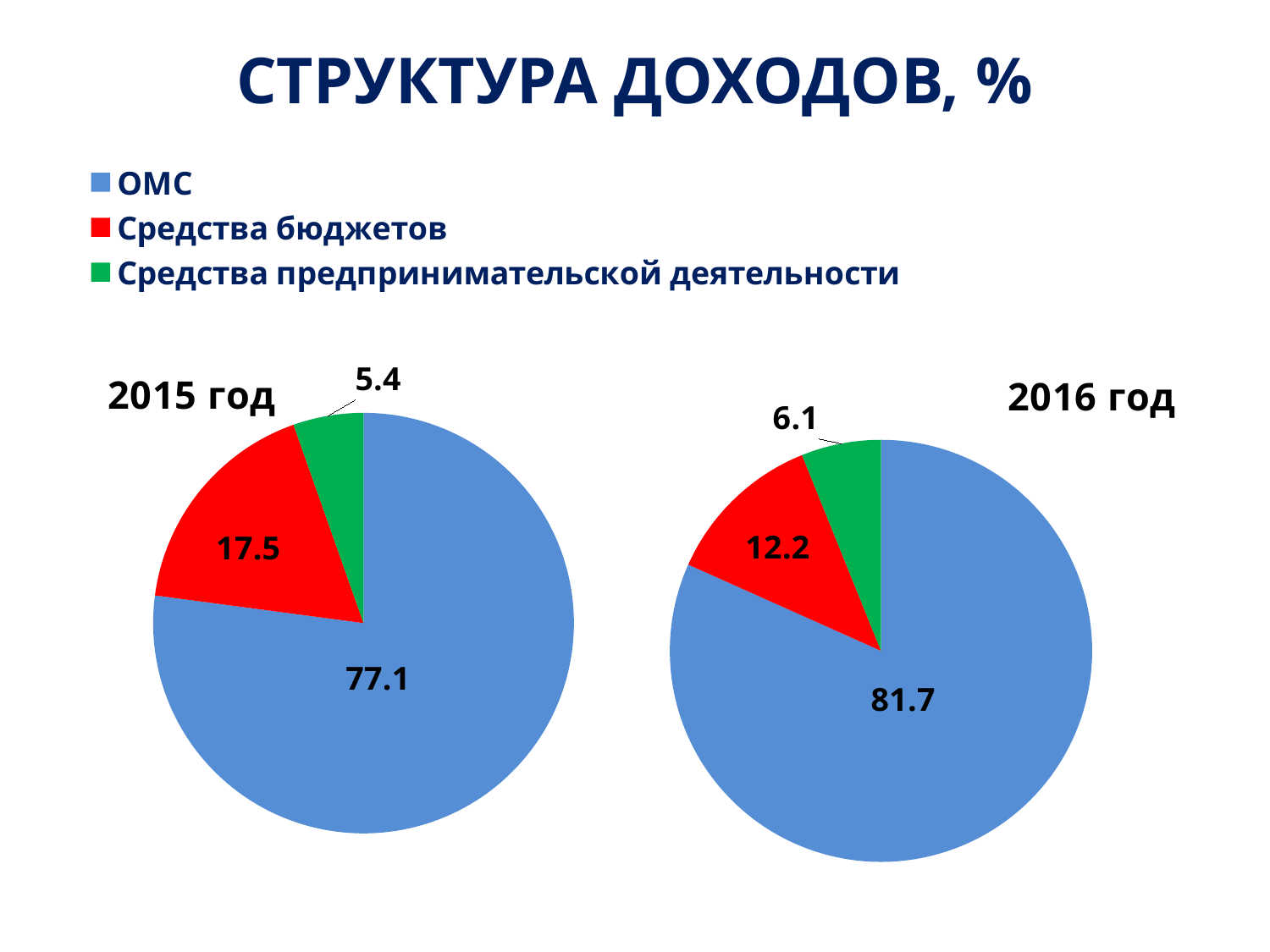
Which is larger: the ОМС value in the 2015 год chart or in the 2016 год chart? 2016 год What colour represents Средства бюджетов in the charts? Red In the 2015 год pie chart, which category has the smallest slice? Средства предпринимательской деятельности How many entries does the legend list? 3 In the 2015 год pie chart, what is the value for ОМС? 77.1 How many slices does the 2015 год pie chart have? 3 In the 2016 год pie chart, what is the value for Средства бюджетов? 12.2 What type of chart is used on this slide? Pie chart In the 2015 год pie chart, what is the value for Средства предпринимательской деятельности? 5.4 In the 2016 год pie chart, which category has the largest slice? ОМС What is the difference between the Средства бюджетов values in the 2015 год and 2016 год pie charts? 5.3 In the 2016 год pie chart, what is the value for ОМС? 81.7